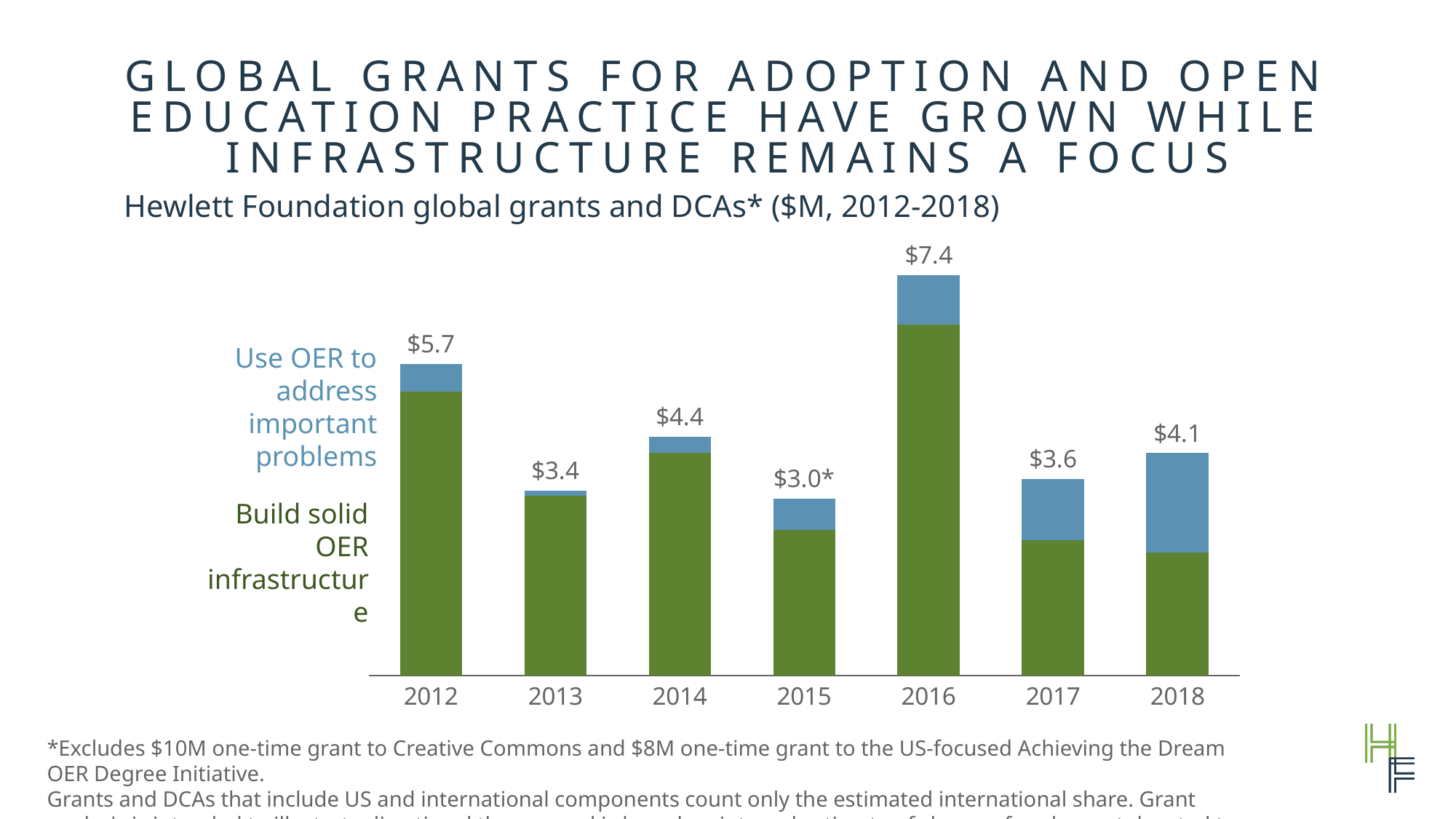
What is the total value shown for 2012? $5.7 Which colour represents 'Build solid OER infrastructure'? Green How many years are shown on the x axis? 7 How many series are shown in the stacked bars? 2 Which year has a larger total, 2014 or 2017? 2014 What is the total value shown for 2018? $4.1 What is the difference between the 2012 total and the 2013 total? $2.3 Which year has the lowest total grants? 2015 What is the difference between the 2016 total and the 2015 total? $4.4 What is the total value shown for 2016? $7.4 Which year has the highest total grants? 2016 What kind of chart is shown on the slide? Stacked bar chart